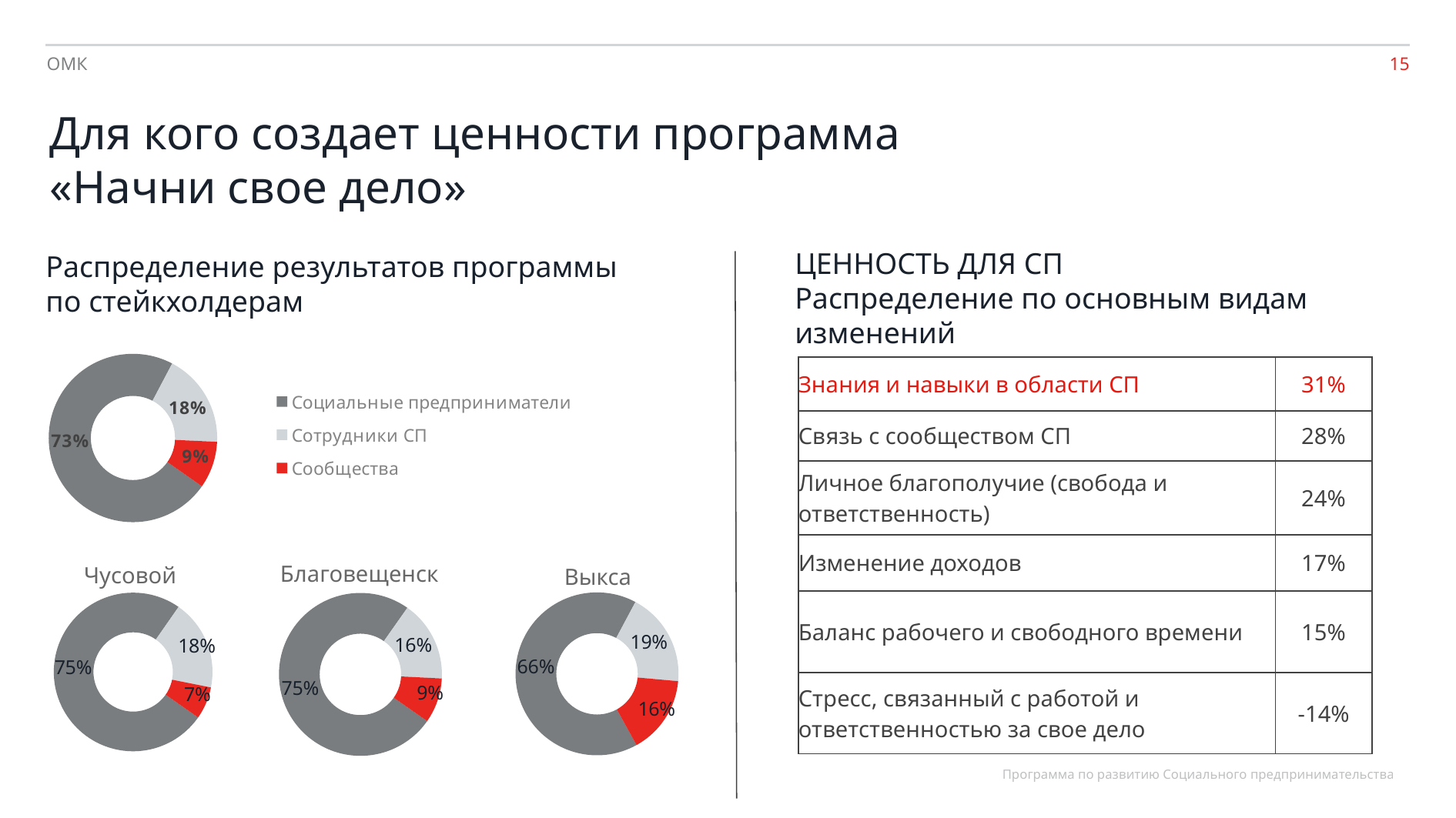
What type of chart is used to show the distribution of program results by stakeholders? Donut (pie) chart In the Выкса donut chart, which category has the smallest share? Сообщества In the top-left donut chart (overall distribution by stakeholders), what share is attributed to Социальные предприниматели? 73% Which chart shows a larger share for Сообщества: Чусовой or Выкса? Выкса In the Благовещенск donut chart, what share is attributed to Социальные предприниматели? 75% What is the difference between the Социальные предприниматели share in the Чусовой chart and in the Выкса chart? 9% In the Чусовой donut chart, what share is attributed to Сотрудники СП? 18% In the top-left donut chart (overall distribution by stakeholders), what share is attributed to Сообщества? 9% Which colour represents Сообщества in the stakeholder distribution charts? Red In the Чусовой donut chart, which category has the largest share? Социальные предприниматели In the Выкса donut chart, what share is attributed to Сообщества? 16% How many series does the legend of the stakeholder distribution charts list? 3